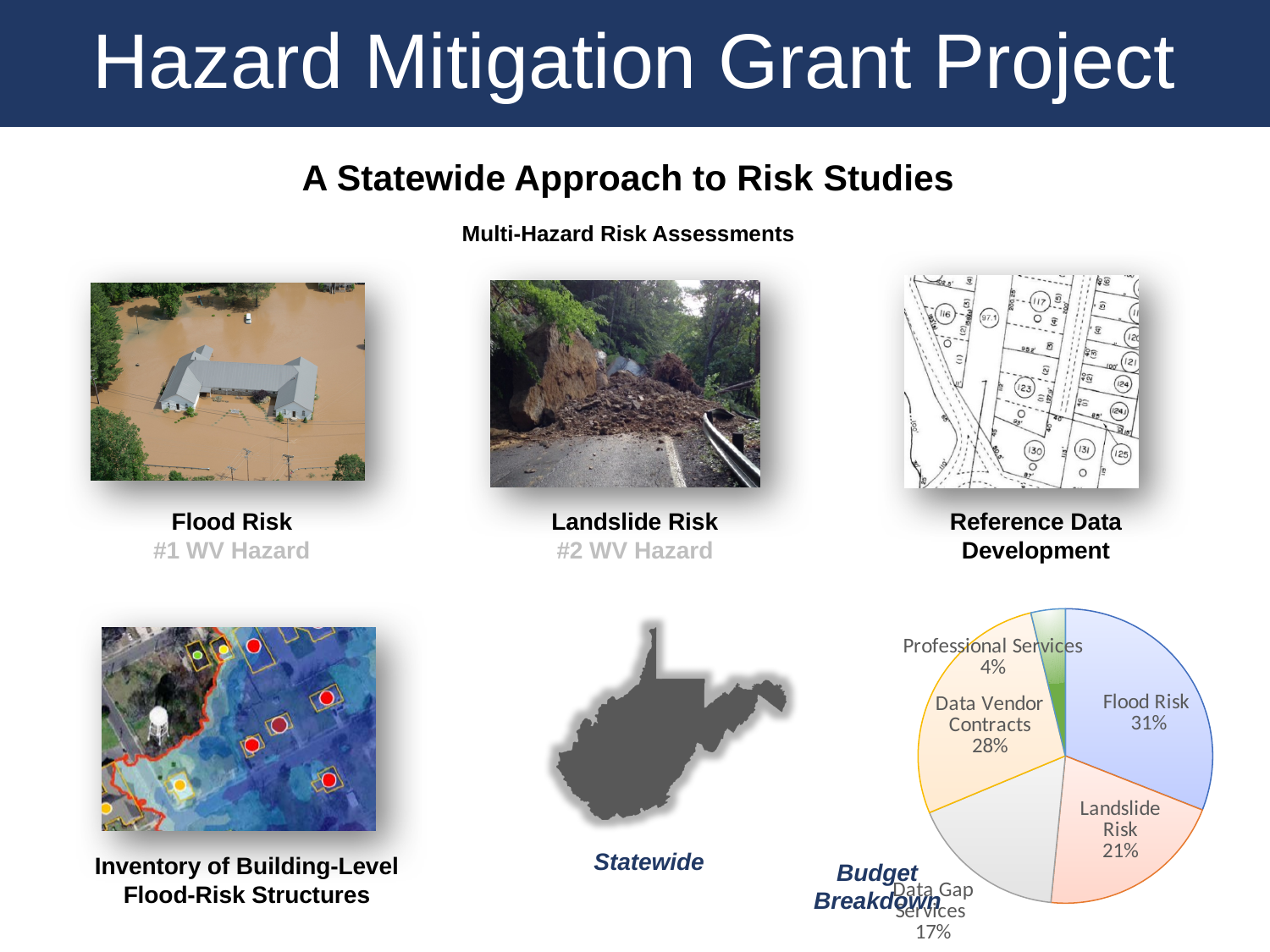
What type of chart is the Budget Breakdown chart? pie chart In the Budget Breakdown pie chart, what share do Data Gap Services have? 17% In the Budget Breakdown pie chart, what share do Professional Services have? 4% In the Budget Breakdown pie chart, which is larger: Data Vendor Contracts or Data Gap Services? Data Vendor Contracts In the Budget Breakdown pie chart, which labeled category has the smallest share? Professional Services What is the title of the pie chart on the slide? Budget Breakdown In the Budget Breakdown pie chart, what share does Landslide Risk have? 21% In the Budget Breakdown pie chart, which labeled category has the largest share? Flood Risk In the Budget Breakdown pie chart, what is the difference in percentage points between Flood Risk and Landslide Risk? 10 In the Budget Breakdown pie chart, what share do Data Vendor Contracts have? 28% In the Budget Breakdown pie chart, what is the combined share of Flood Risk and Landslide Risk? 52% In the Budget Breakdown pie chart, what share does Flood Risk have? 31%